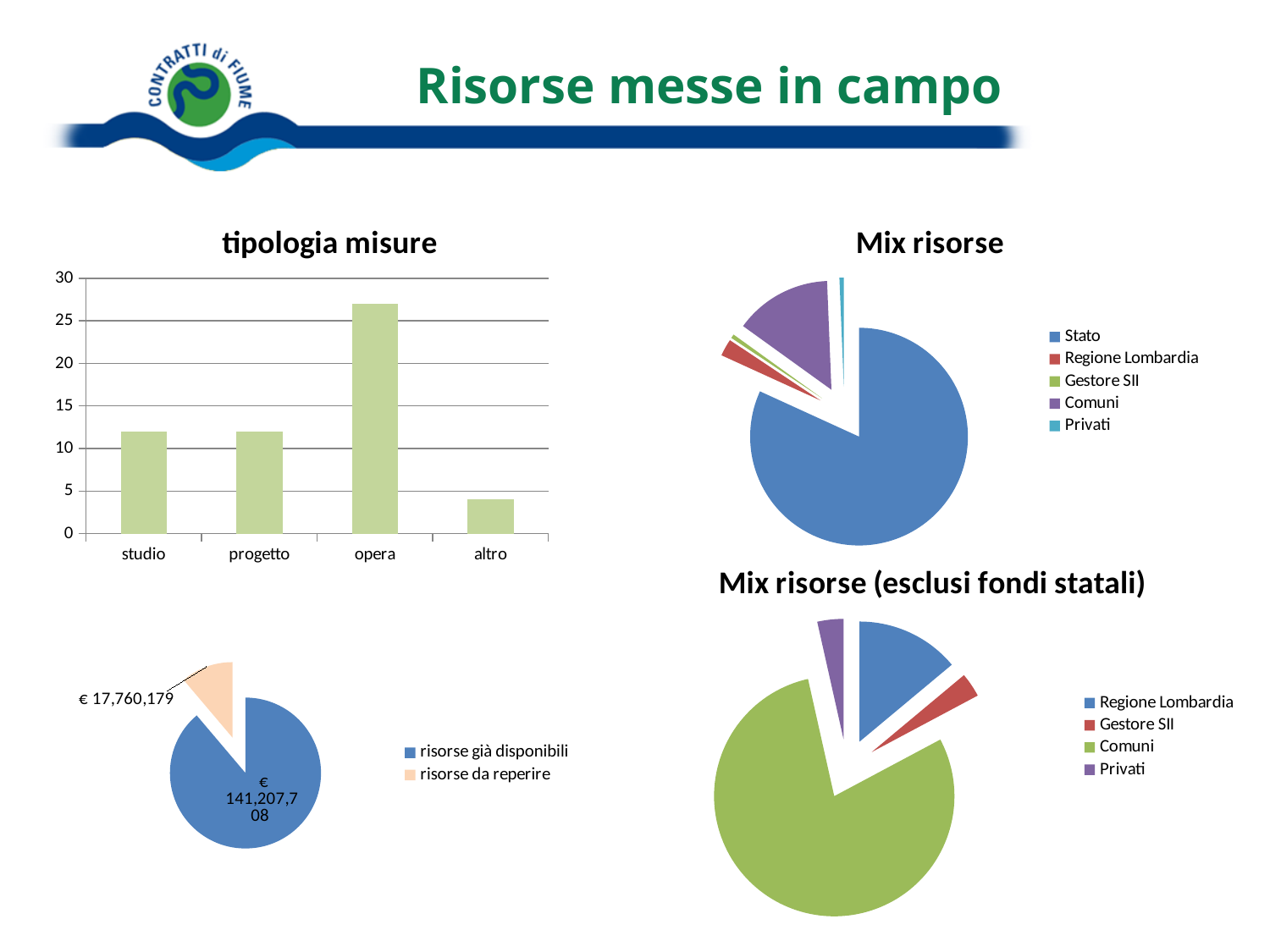
In the 'tipologia misure' chart, is the value for altro greater or less than 5? less How many entries does the legend of the 'Mix risorse' pie chart list? 5 In the bottom-left pie chart, what is the value for 'risorse da reperire'? € 17,760,179 In the bottom-left pie chart, what is the value for 'risorse già disponibili'? € 141,207,708 In the 'tipologia misure' chart, which category has the highest value? opera In the 'Mix risorse' pie chart, which category has the largest slice? Stato In the 'tipologia misure' chart, which category has the lowest value? altro What kind of chart is 'tipologia misure'? bar chart How many categories are shown on the x axis of the 'tipologia misure' chart? 4 In the 'tipologia misure' chart, is the value for studio greater or less than 10? greater In the 'Mix risorse (esclusi fondi statali)' pie chart, which category has the largest slice? Comuni In the 'tipologia misure' chart, is the value for opera greater or less than 25? greater